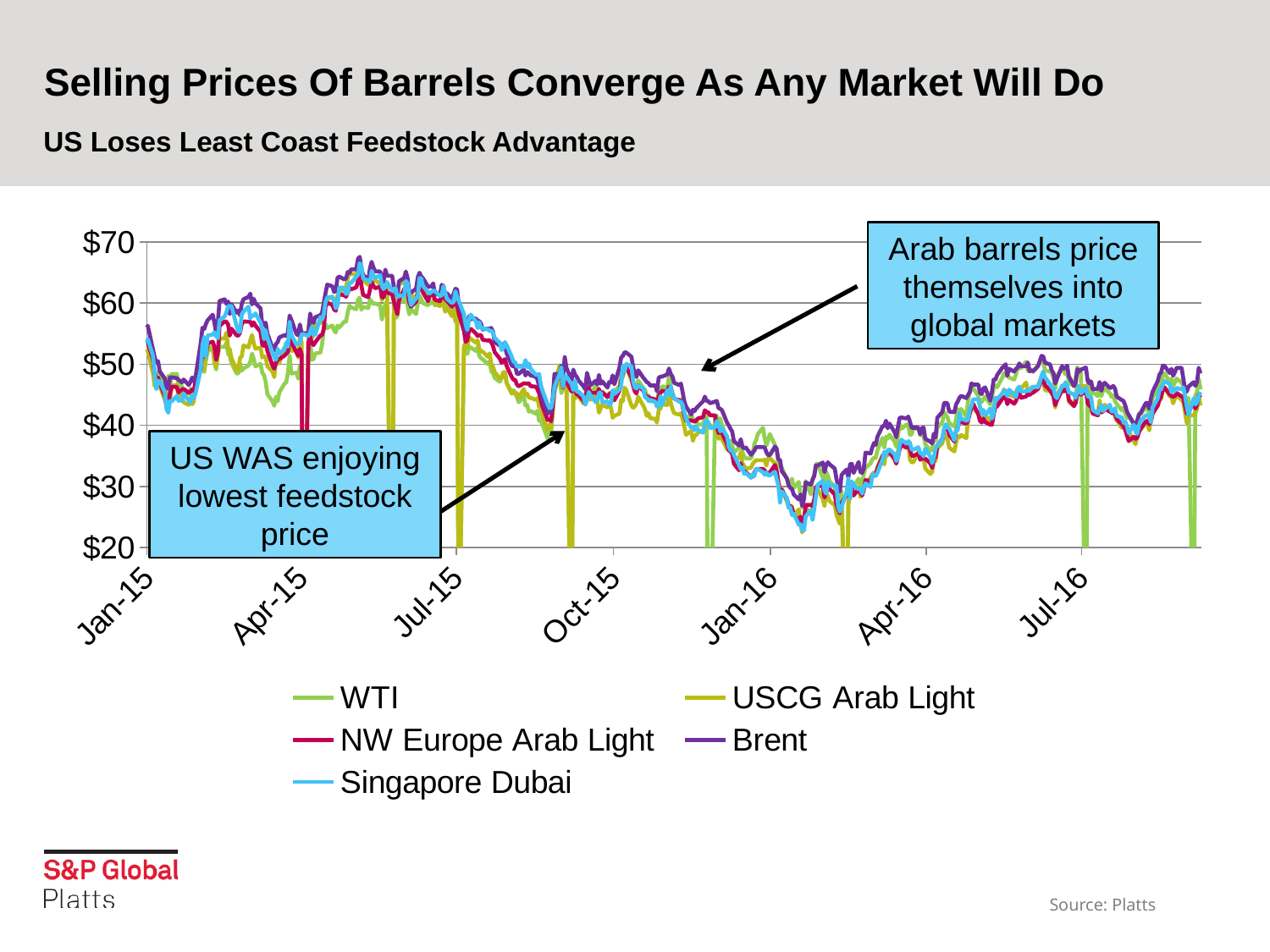
How many series does the chart's legend list? 5 How many date labels are shown along the x axis of the chart? 7 Is the value of the Brent line at Jul-16 greater or less than $40? greater Which series is generally the highest line across the chart? Brent Is the value of the WTI line at Jan-15 greater or less than $60? less What kind of chart is shown on the slide? line chart Is the value of the Brent line at Jul-15 greater or less than $50? greater What does the callout box in the upper right of the chart say? Arab barrels price themselves into global markets Which series are listed in the chart's legend? WTI, USCG Arab Light, NW Europe Arab Light, Brent, Singapore Dubai Do the prices generally rise or fall between Jul-15 and Jan-16? fall Do the prices generally rise or fall between Jan-16 and Jul-16? rise